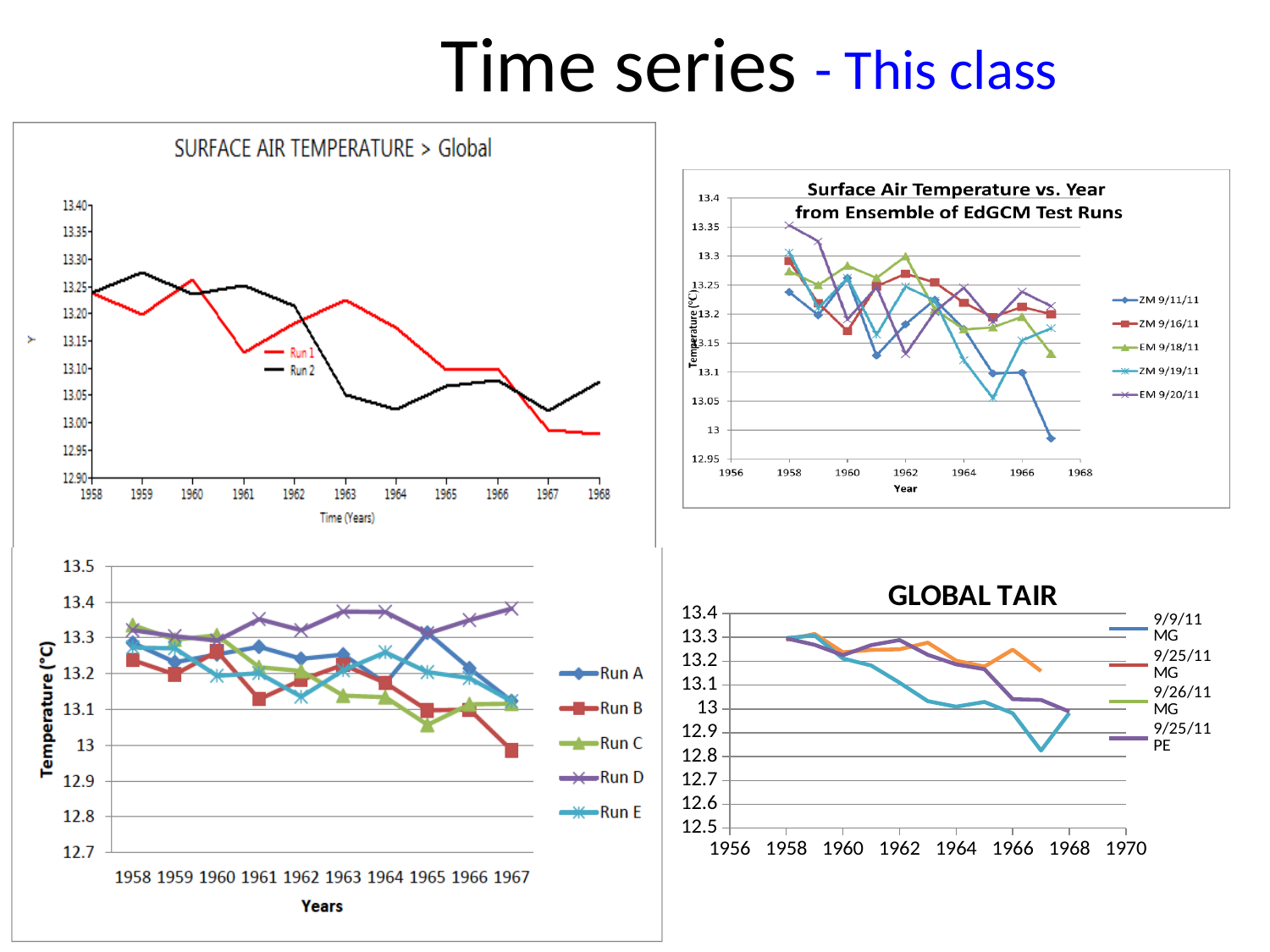
In the top-right chart 'Surface Air Temperature vs. Year from Ensemble of EdGCM Test Runs', how many series does the legend list? 5 In the top-left chart 'SURFACE AIR TEMPERATURE > Global', is the value for Run 1 in 1963 greater or less than 13.20? greater In the top-left chart 'SURFACE AIR TEMPERATURE > Global', how many series does the legend list? 2 In the top-right chart 'Surface Air Temperature vs. Year from Ensemble of EdGCM Test Runs', is the value for ZM 9/16/11 in 1960 greater or less than 13.2? less In the bottom-left chart with the legend Run A to Run E, is the value for Run C in 1965 greater or less than 13.1? less In the bottom-left chart with the legend Run A to Run E, which series has the highest value in 1967? Run D In the bottom-right chart 'GLOBAL TAIR', how many series does the legend list? 4 In the top-left chart 'SURFACE AIR TEMPERATURE > Global', does Run 1 generally rise or fall from 1958 to 1968? Fall What type of chart is the top-left chart titled 'SURFACE AIR TEMPERATURE > Global'? Line chart In the bottom-left chart with the legend Run A to Run E, how many years are shown on the x axis? 10 In the top-right chart 'Surface Air Temperature vs. Year from Ensemble of EdGCM Test Runs', which series has the lowest value in 1967? ZM 9/11/11